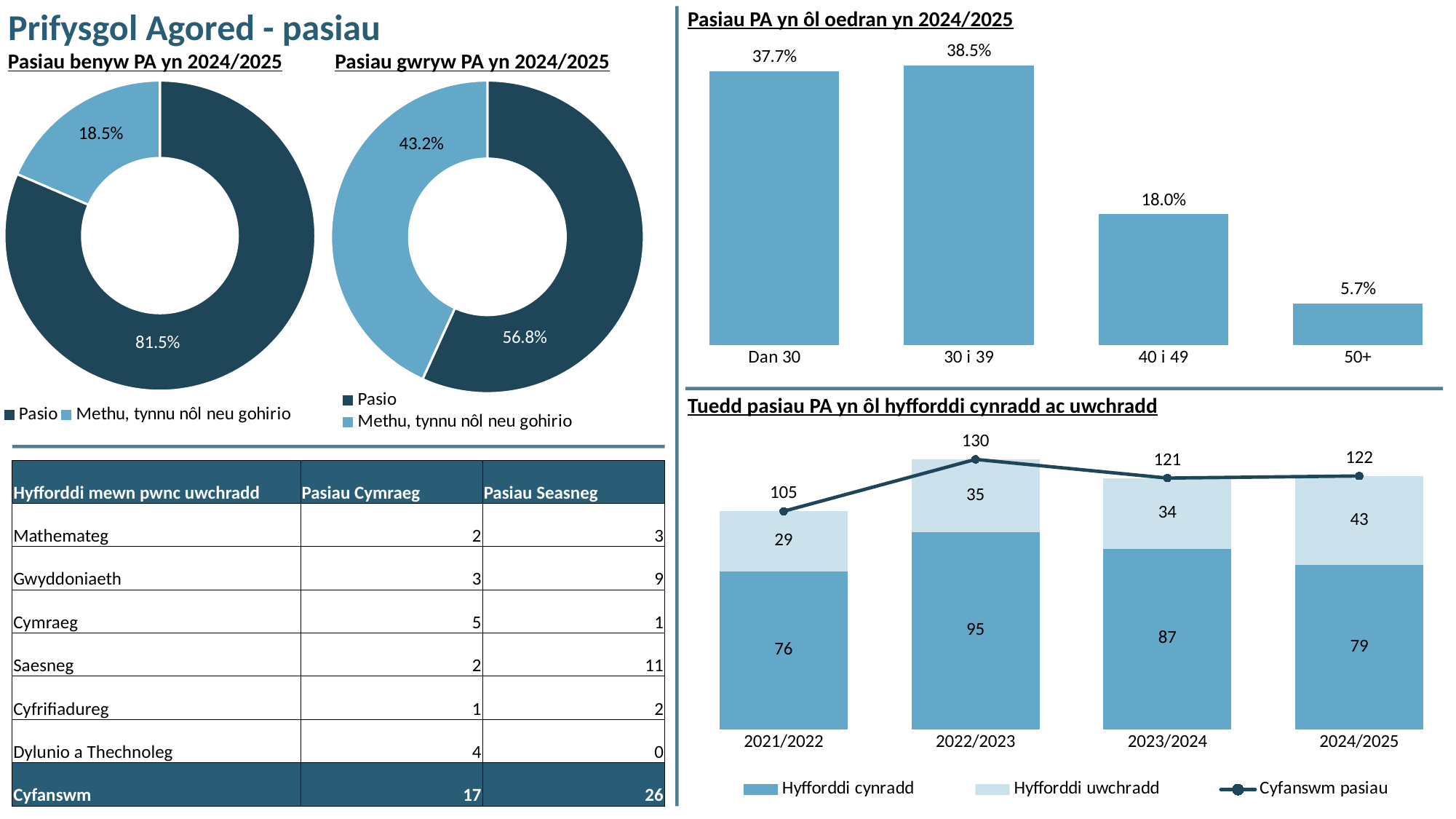
In the 'Pasiau PA yn ôl oedran yn 2024/2025' chart, how many age groups are shown? 4 In the 'Pasiau PA yn ôl oedran yn 2024/2025' chart, which age group has the lowest value? 50+ In the 'Tuedd pasiau PA yn ôl hyfforddi cynradd ac uwchradd' chart, how many series does the legend list? 3 What kind of chart is 'Pasiau benyw PA yn 2024/2025'? Donut (pie) chart In the 'Pasiau benyw PA yn 2024/2025' chart, what share is labelled for 'Pasio'? 81.5% In the 'Tuedd pasiau PA yn ôl hyfforddi cynradd ac uwchradd' chart, what is the 'Cyfanswm pasiau' value for 2024/2025? 122 In the 'Pasiau PA yn ôl oedran yn 2024/2025' chart, which age group has the highest value? 30 i 39 In the 'Tuedd pasiau PA yn ôl hyfforddi cynradd ac uwchradd' chart, which year has the highest 'Cyfanswm pasiau'? 2022/2023 In the 'Tuedd pasiau PA yn ôl hyfforddi cynradd ac uwchradd' chart, what is the difference between 'Hyfforddi uwchradd' in 2024/2025 and in 2021/2022? 14 In the 'Tuedd pasiau PA yn ôl hyfforddi cynradd ac uwchradd' chart, what is the value for 'Hyfforddi cynradd' in 2022/2023? 95 In the 'Pasiau PA yn ôl oedran yn 2024/2025' chart, what is the value for '40 i 49'? 18.0% In the 'Pasiau gwryw PA yn 2024/2025' chart, what share is labelled for 'Methu, tynnu nôl neu gohirio'? 43.2%